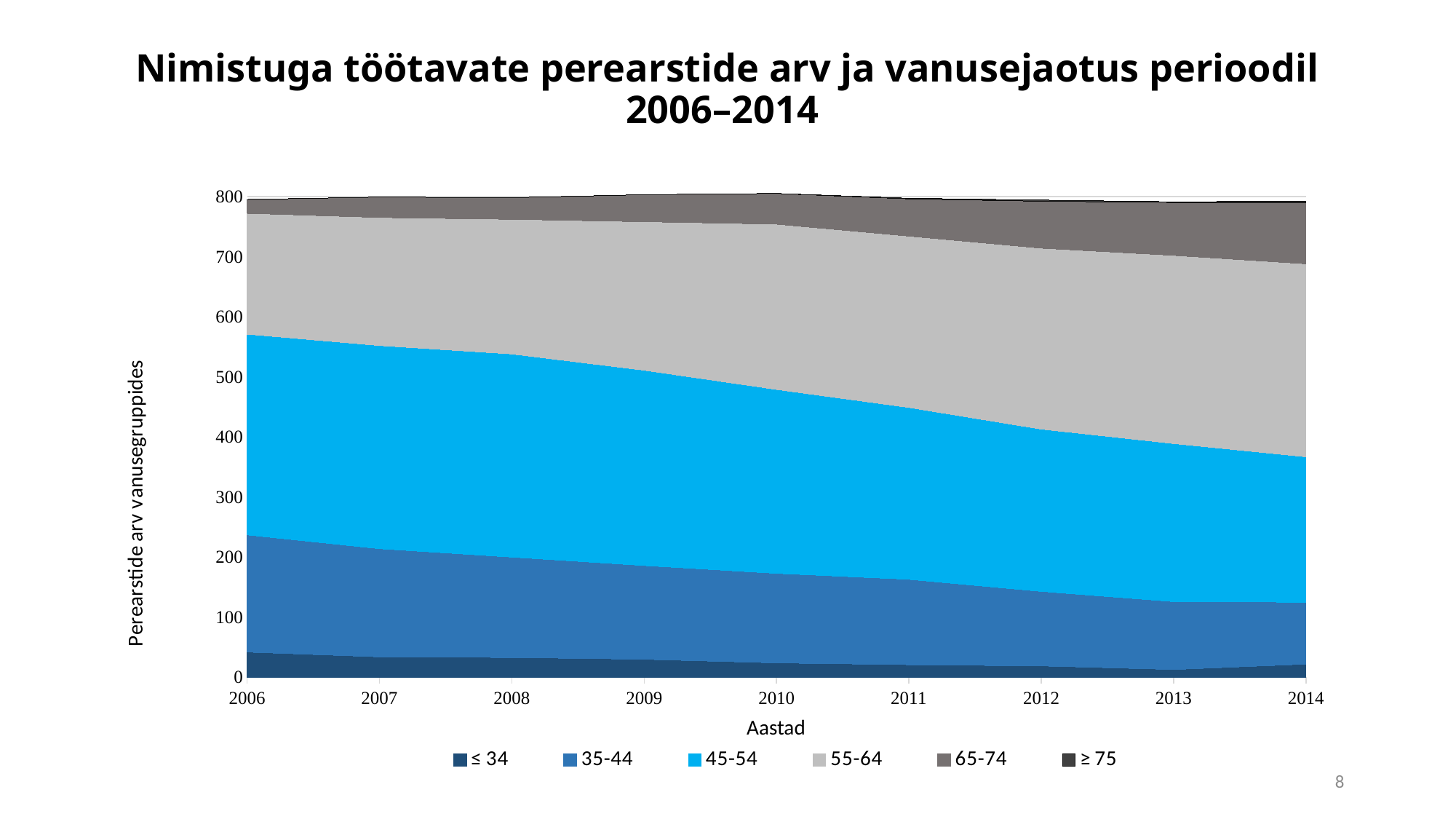
Which year is the first on the x axis? 2006 Which age group is the largest band in 2014, 45-54 or 55-64? 55-64 How many years are plotted along the x axis? 9 Is the value for the ≤ 34 group in 2006 greater or less than 100? less Does the 65-74 age band get thicker or thinner from 2006 to 2014? Thicker What kind of chart is shown on the slide? Stacked area chart How many age-group series does the legend list? 6 Does the 55-64 age band get thicker or thinner from 2006 to 2014? Thicker What is the title of the x axis? Aastad Is the total number of doctors in 2014 (top of the stacked area) greater or less than 700? greater Is the value for the 35-44 group in 2006 greater or less than 100? greater Does the 45-54 age band get thicker or thinner from 2006 to 2014? Thinner